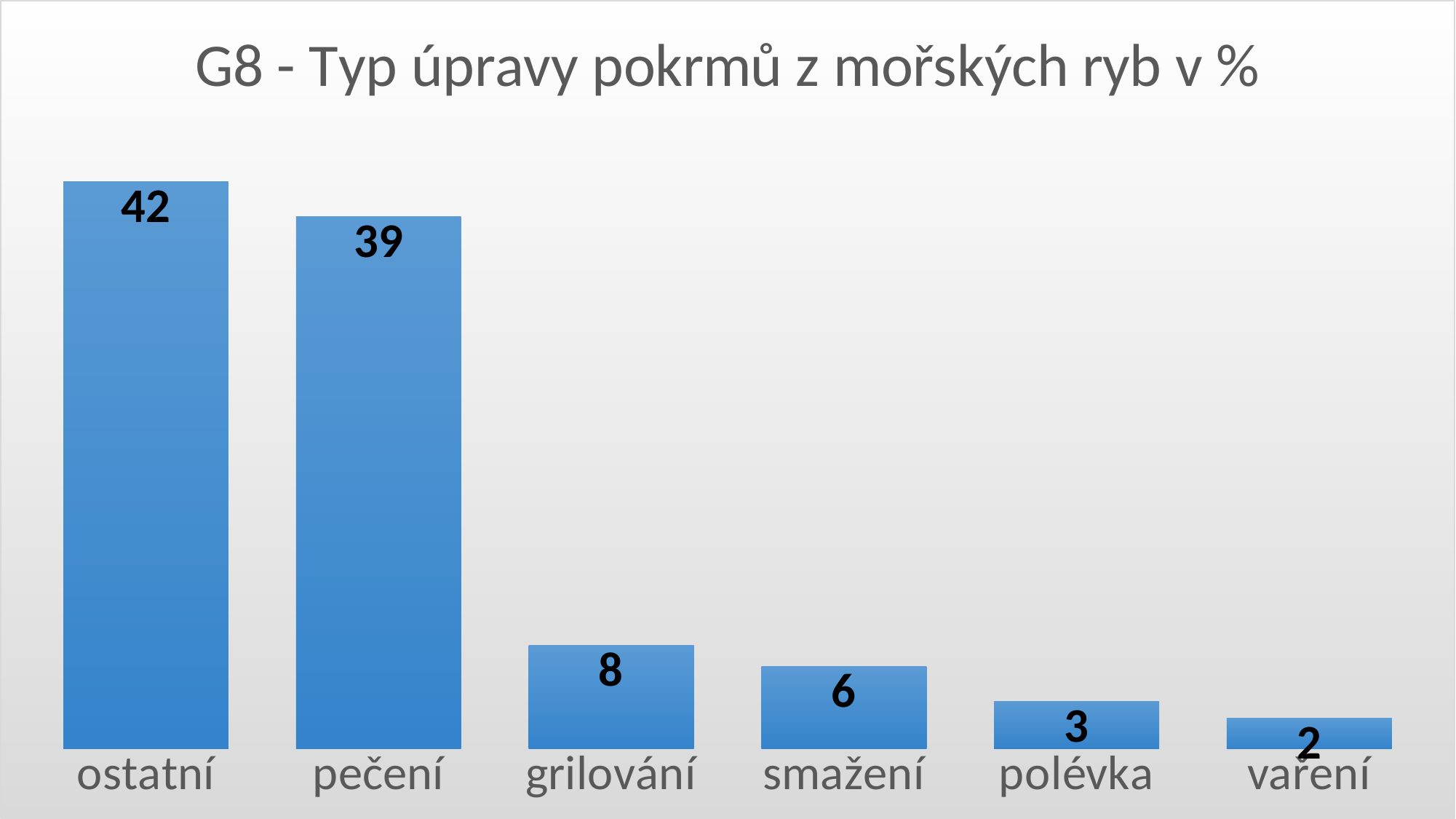
What kind of chart is shown on the slide? bar chart Which category has the highest value? ostatní What is the difference between the values for grilování and smažení? 2 How many categories are shown in the chart? 6 Which is larger, the value for smažení or the value for polévka? smažení What is the difference between the values for ostatní and pečení? 3 Do the values rise or fall from left to right along the x axis? fall What is the value for pečení? 39 What is the value for polévka? 3 What is the value for grilování? 8 Which category has the lowest value? vaření What is the title of the chart? G8 - Typ úpravy pokrmů z mořských ryb v %